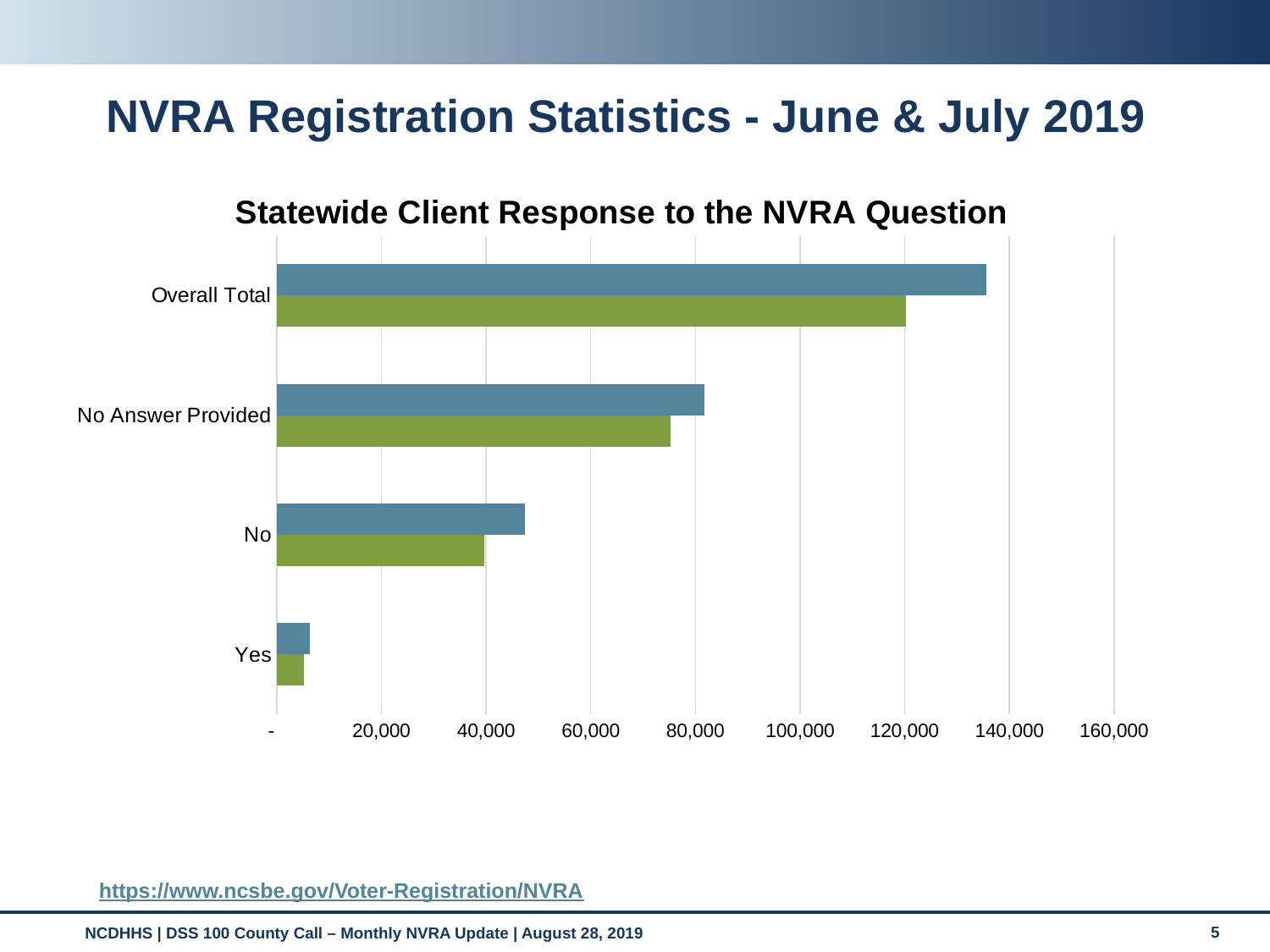
What is the title of the chart? Statewide Client Response to the NVRA Question Is the blue bar for Overall Total greater or less than 120,000? greater For No Answer Provided, which bar is longer, the blue bar or the green bar? the blue bar Is the blue bar for Yes greater or less than 20,000? less Which category has the lowest values on the chart? Yes Is the green bar for No Answer Provided greater or less than 80,000? less How many bars are shown for each category? 2 What kind of chart is shown on the slide? bar chart How many response categories are shown on the chart? 4 Which category has the highest values on the chart? Overall Total Which is larger, the blue bar for No or the green bar for No Answer Provided? the green bar for No Answer Provided